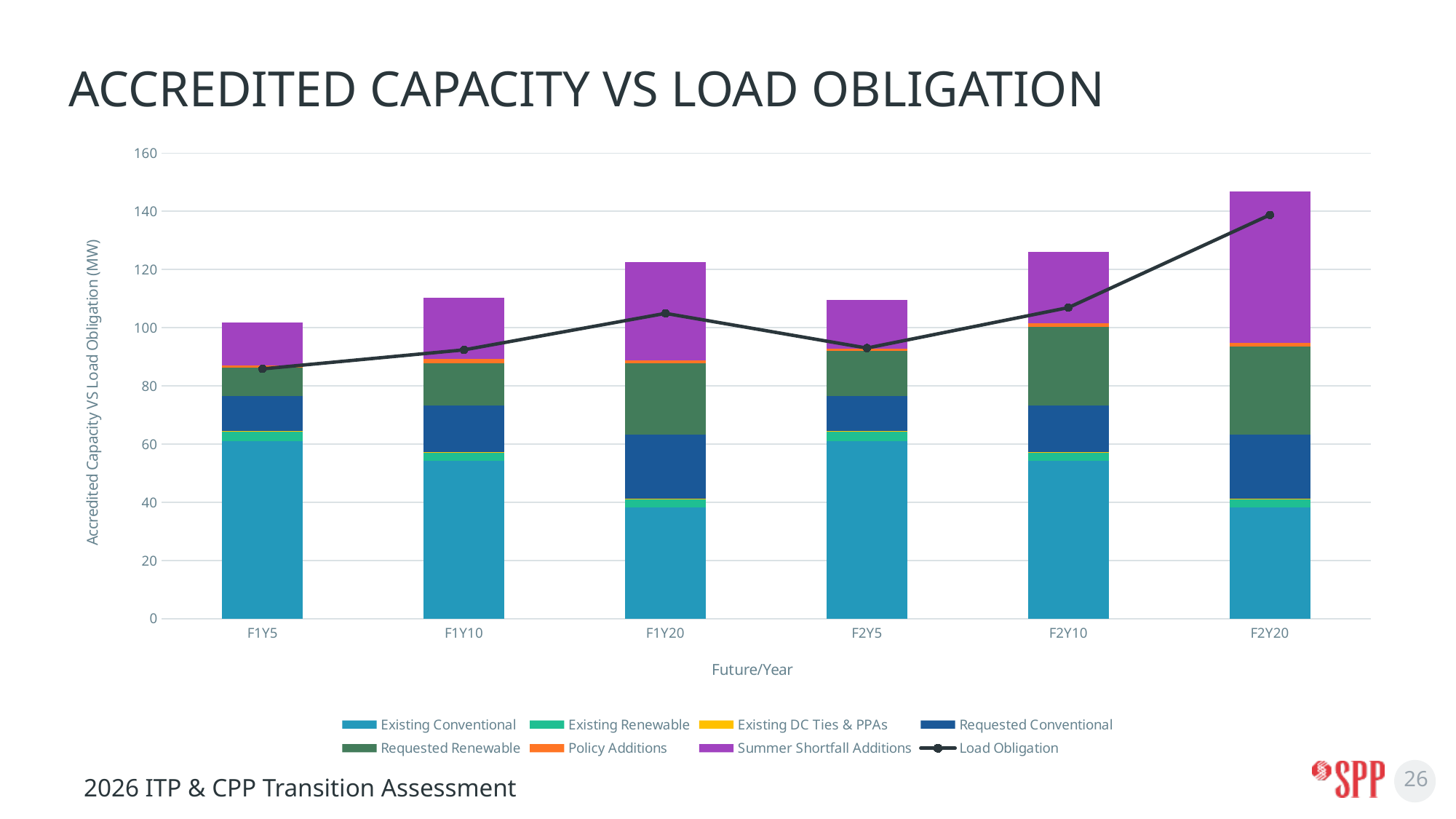
Which Future/Year has the shortest stacked bar? F1Y5 Which Future/Year has the highest Load Obligation? F2Y20 What kind of chart is this? stacked bar and line chart Which has the taller stacked bar, F2Y5 or F2Y10? F2Y10 What is the title of the chart's y axis? Accredited Capacity VS Load Obligation (MW) How many series does the legend list? 8 Does the Load Obligation line rise or fall from F2Y5 to F2Y20? rise Is the Existing Conventional value for F1Y20 greater or less than 60? less Which Future/Year has the tallest stacked bar? F2Y20 How many Future/Year categories are shown on the x axis? 6 Is the total stacked bar for F2Y20 greater or less than 140? greater Is the Load Obligation for F1Y5 greater or less than 100? less